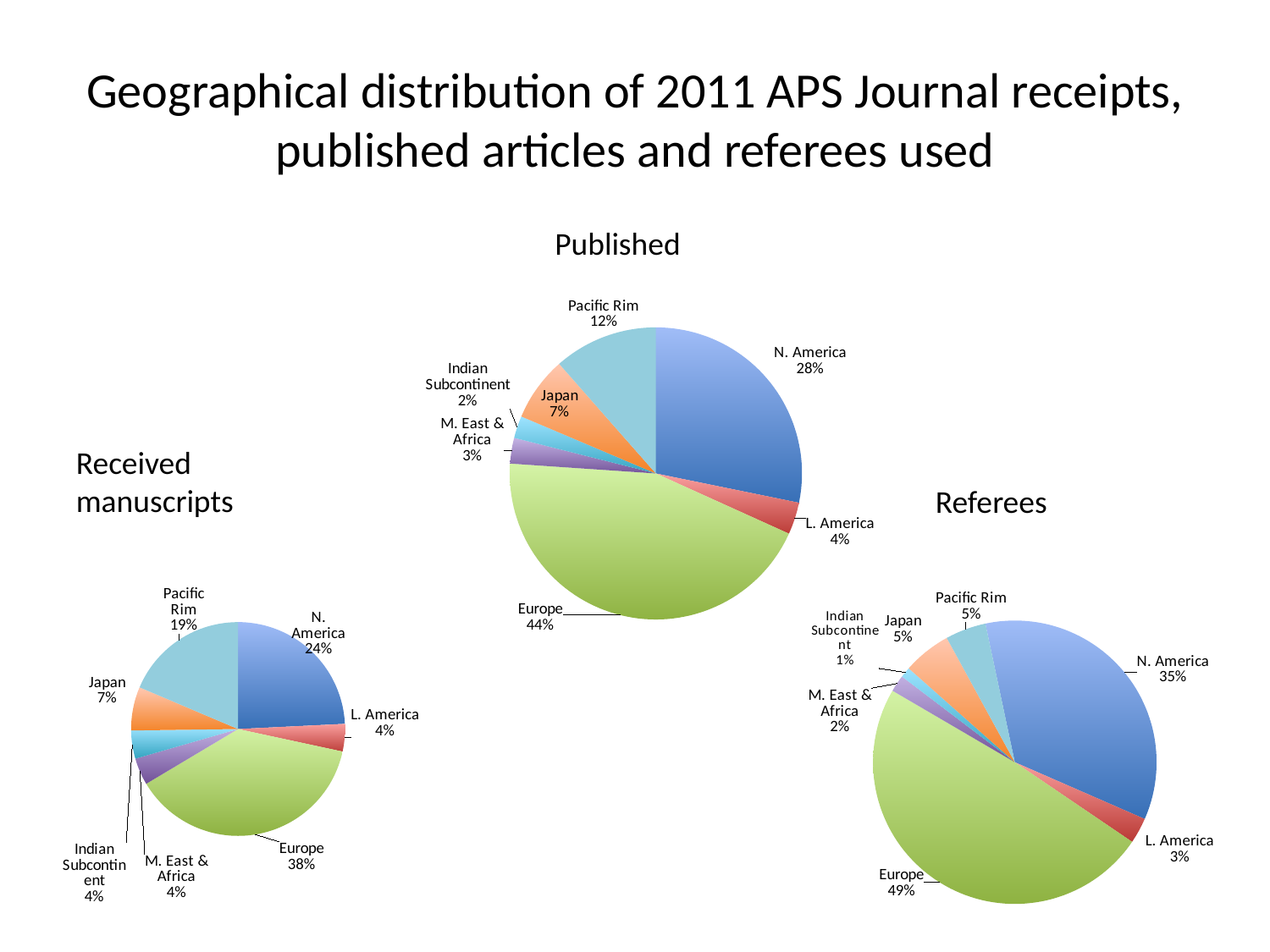
What kind of chart is the Published chart? Pie chart In the Published pie chart, what share does Europe have? 44% In the Referees pie chart, what share does N. America have? 35% In the Referees pie chart, what share does Japan have? 5% In the Referees pie chart, which region has the smallest share? Indian Subcontinent In the Referees pie chart, which region has the largest share? Europe In the Received manuscripts pie chart, which is larger, the share for Pacific Rim or the share for Japan? Pacific Rim How many slices does the Received manuscripts pie chart have? 7 In the Received manuscripts pie chart, what share does Pacific Rim have? 19% How many pie charts are shown on the slide? 3 In the Published pie chart, which region has the smallest share? Indian Subcontinent In the Published pie chart, what is the difference between the Europe share and the N. America share? 16%